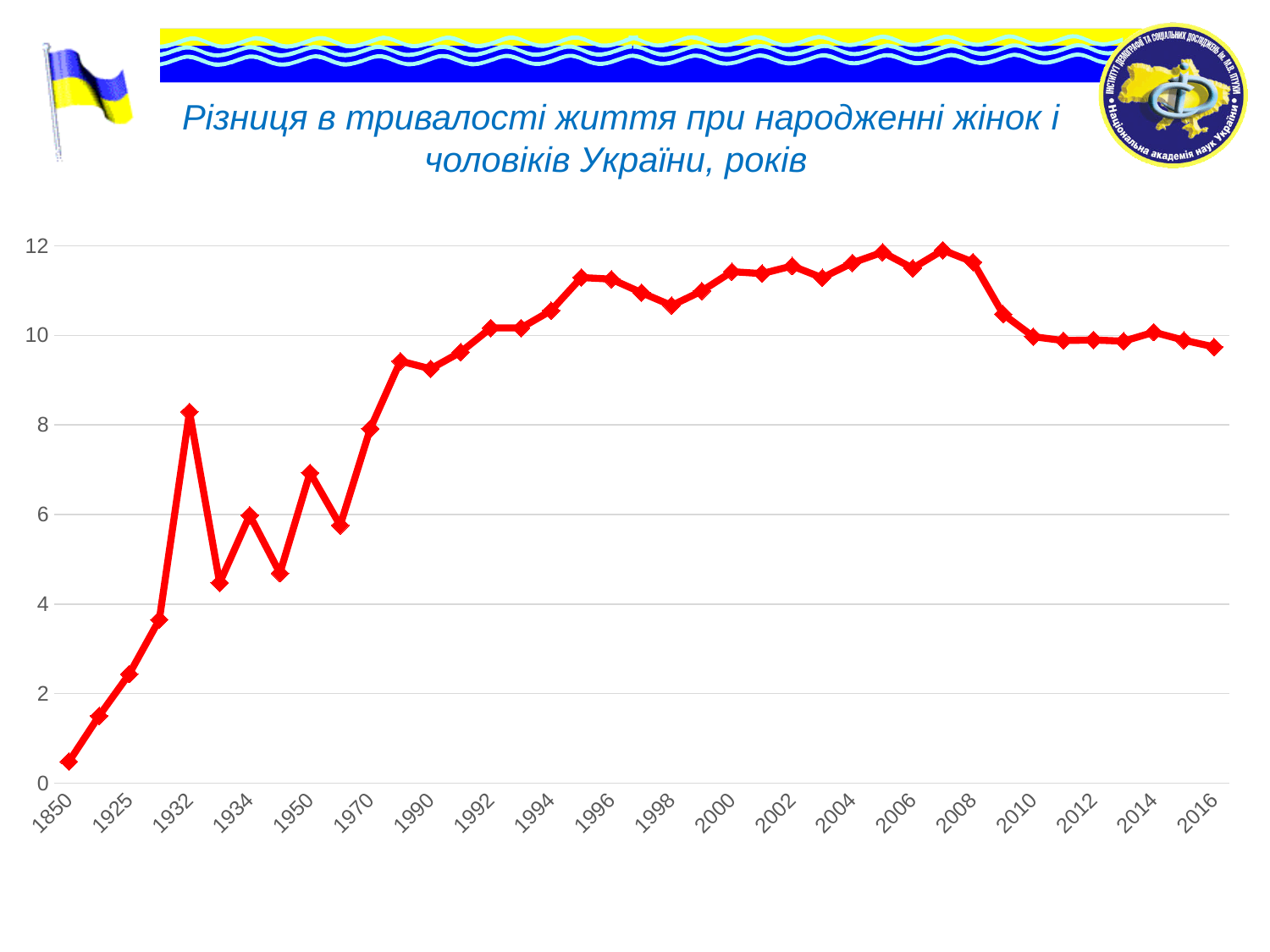
Which year has the lowest value on the chart? 1850 Is the value for 1925 greater or less than 2? greater Do the values rise or fall from 2008 to 2016? fall What kind of chart is shown on the slide? line chart Is the value for 1990 greater or less than 8? greater Is the value for 2016 greater or less than 10? less Which is larger, the value for 1932 or the value for 1934? 1932 What is the title of the chart? Різниця в тривалості життя при народженні жінок і чоловіків України, років